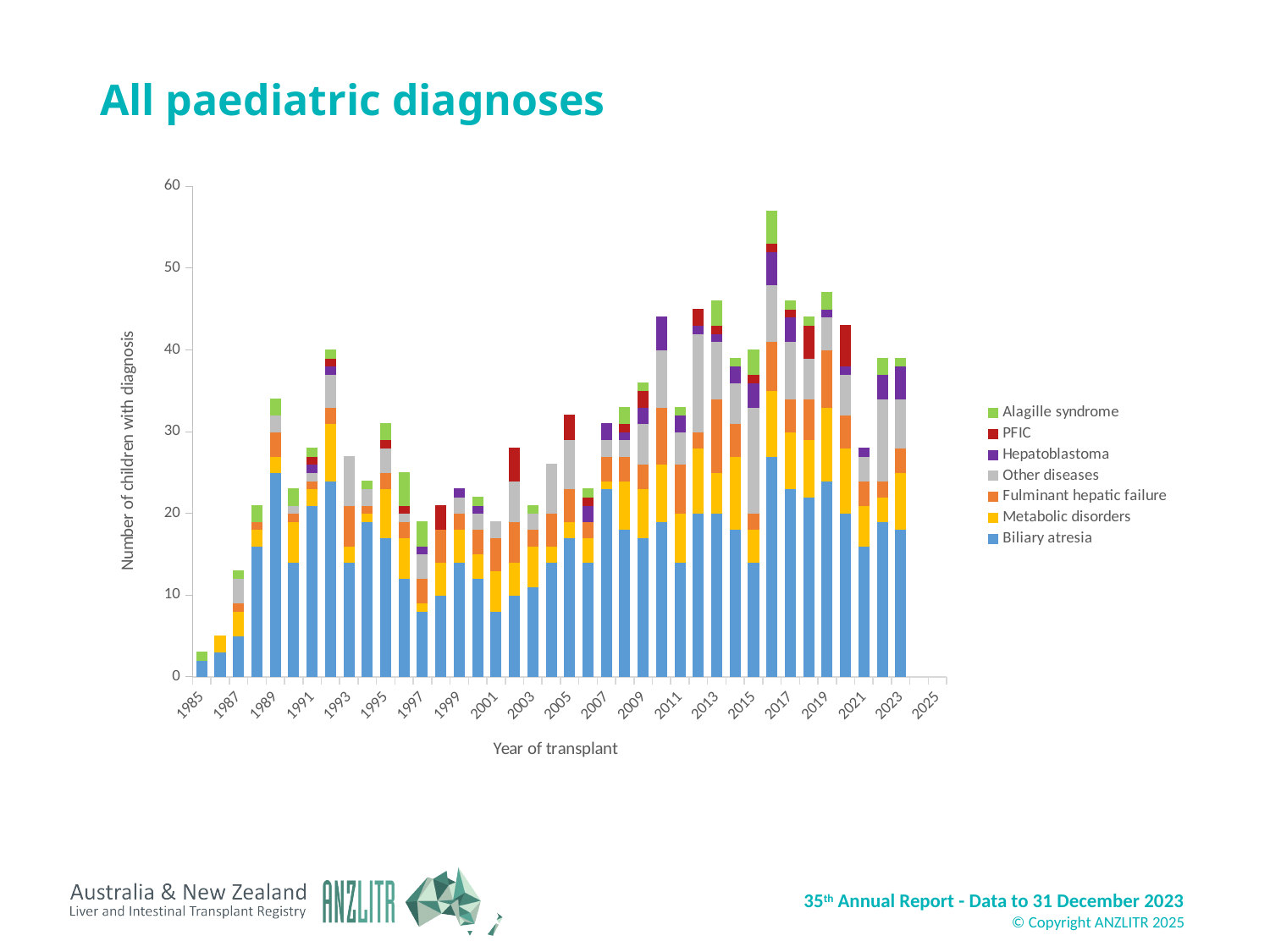
Which year of transplant has the tallest bar (highest total number of children)? 2016 Do the total bar heights rise or fall from 1985 to 1989? rise Which year has the larger total bar, 1985 or 1989? 1989 Is the total number of children for 1985 greater or less than 10? less What kind of chart is shown on the slide? Stacked bar chart What is the label on the vertical axis of the chart? Number of children with diagnosis Which year has the larger total bar, 2016 or 2010? 2016 How many series does the legend list? 7 Is the total number of children for 2016 greater or less than 50? greater Which series is shown at the bottom of each stacked bar (blue segment)? Biliary atresia Is the total number of children for 2010 greater or less than 40? greater Which year of transplant has the shortest bar (lowest total number of children)? 1985